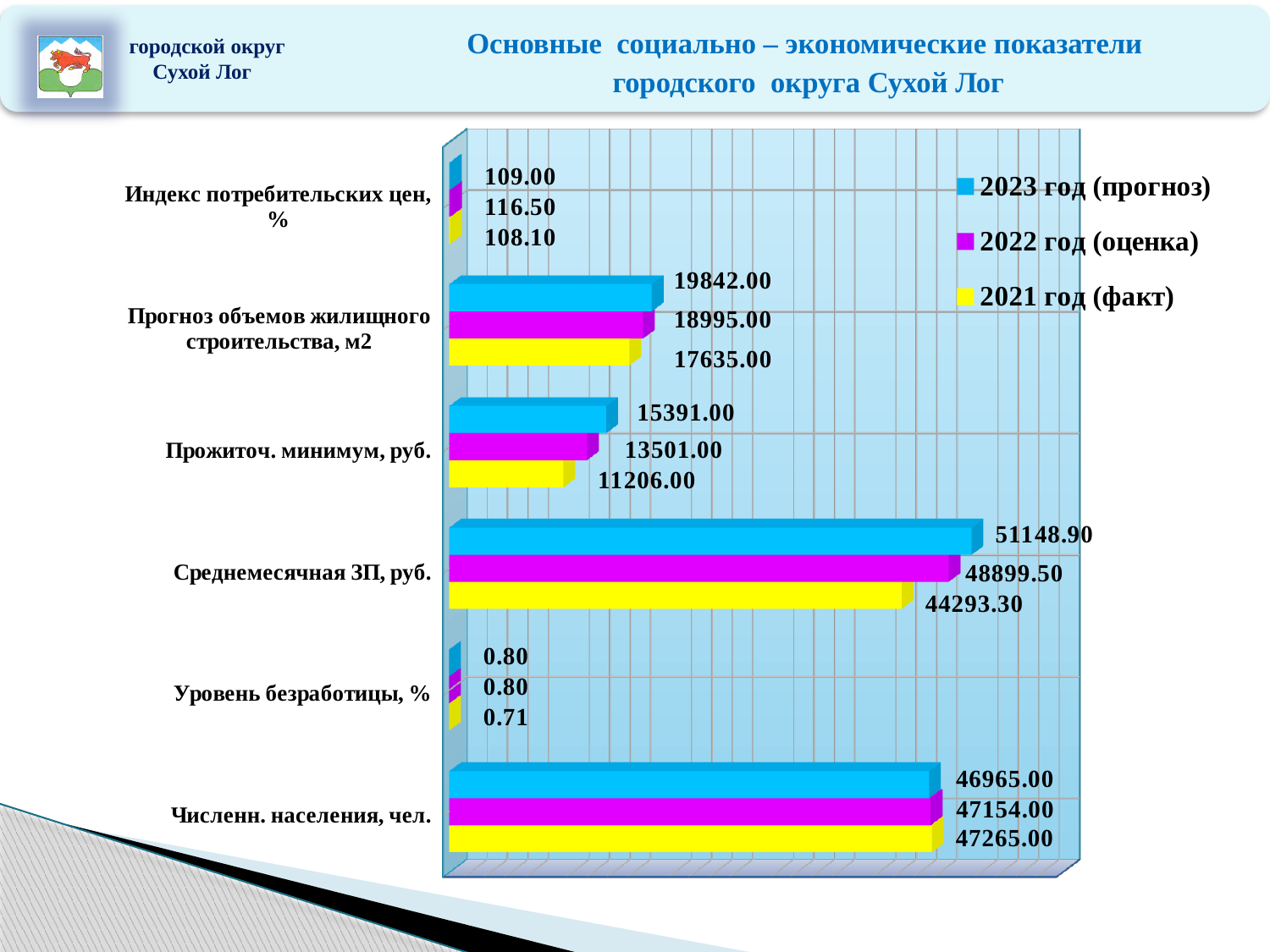
Which category has the highest value for 2023 год (прогноз)? Среднемесячная ЗП, руб. What is the value of Прожиточ. минимум, руб. for 2021 год (факт)? 11206.00 How many categories are plotted on the chart? 6 Which is larger for Численн. населения, чел.: the 2021 год (факт) value or the 2023 год (прогноз) value? 2021 год (факт) What is the value of Среднемесячная ЗП, руб. for 2023 год (прогноз)? 51148.90 What is the value of Численн. населения, чел. for 2023 год (прогноз)? 46965.00 What is the difference between the 2023 год (прогноз) and 2021 год (факт) values for Среднемесячная ЗП, руб.? 6855.60 What type of chart is shown on the slide? bar chart What is the difference between the 2023 год (прогноз) and 2021 год (факт) values for Прогноз объемов жилищного строительства, м2? 2207.00 What is the value of Индекс потребительских цен, % for 2022 год (оценка)? 116.50 Which colour represents 2021 год (факт) in the legend? yellow How many series does the legend list? 3